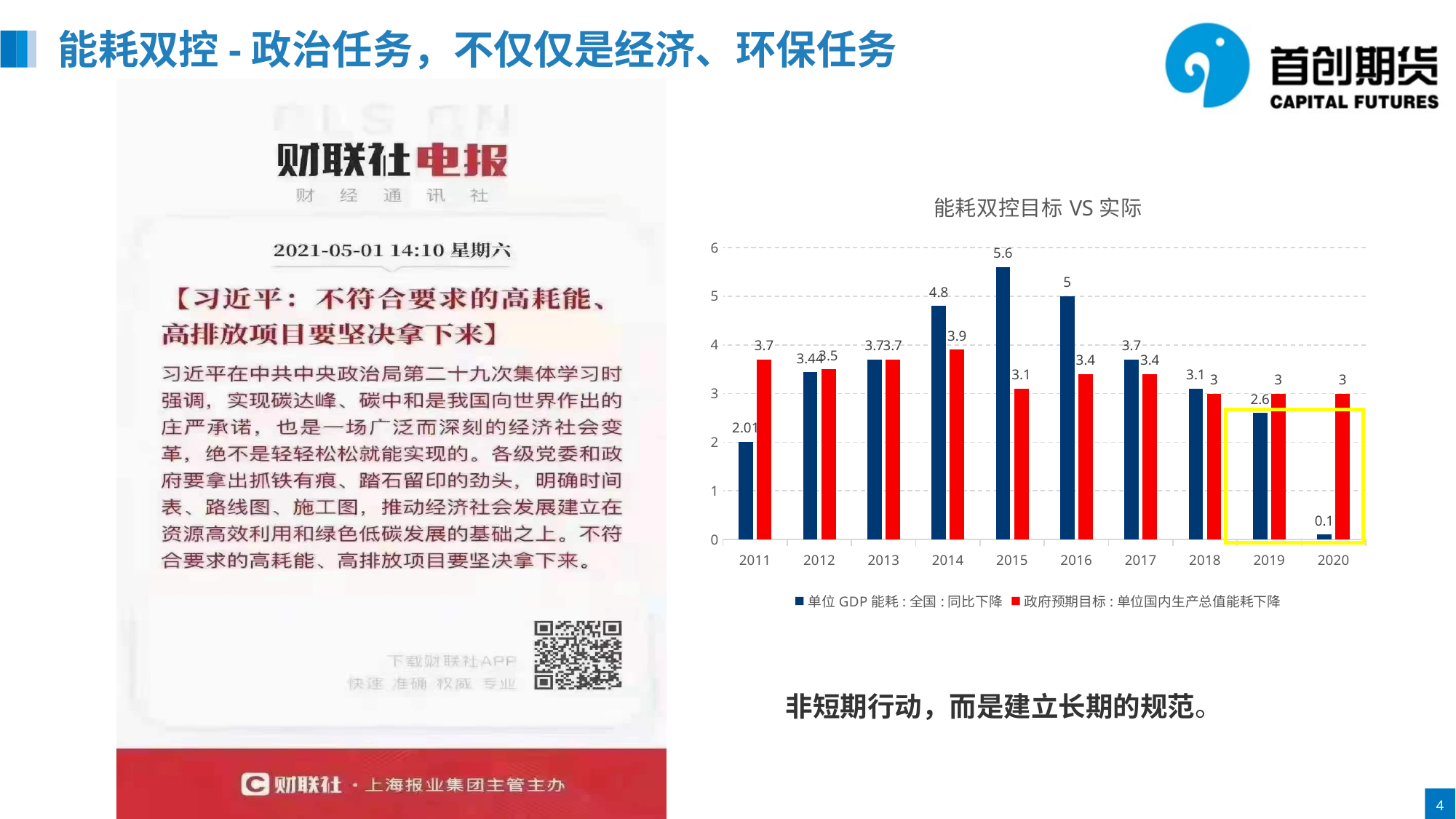
In 2019, which is larger: 单位GDP能耗:全国:同比下降 or 政府预期目标:单位国内生产总值能耗下降? 政府预期目标:单位国内生产总值能耗下降 What type of chart is shown on the slide? bar chart Does 单位GDP能耗:全国:同比下降 rise or fall from 2015 to 2020? fall How many series does the chart legend list? 2 What is the value of 单位GDP能耗:全国:同比下降 for 2020? 0.1 In which year is 单位GDP能耗:全国:同比下降 the highest? 2015 What is the difference between 单位GDP能耗:全国:同比下降 and 政府预期目标:单位国内生产总值能耗下降 in 2015? 2.5 What is the value of 政府预期目标:单位国内生产总值能耗下降 for 2014? 3.9 How many years are shown on the x axis of the chart? 10 What is the value of 单位GDP能耗:全国:同比下降 for 2015? 5.6 What is the title of the chart on the slide? 能耗双控目标 VS 实际 In which year is 单位GDP能耗:全国:同比下降 the lowest? 2020